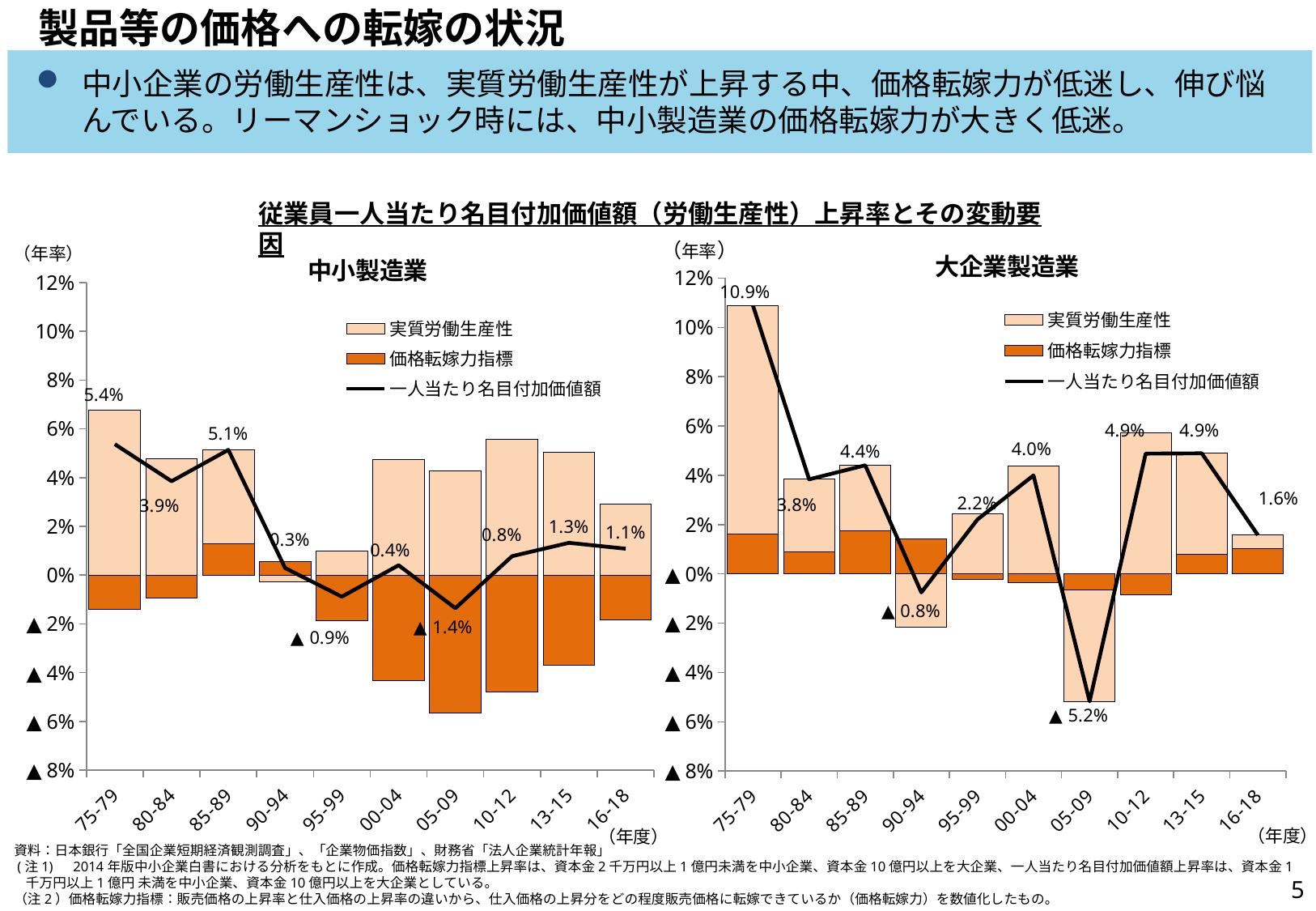
How many series does the legend of the 大企業製造業 chart list? 3 In the 大企業製造業 chart, what is the 一人当たり名目付加価値額 value for 05-09? ▲5.2% In the 中小製造業 chart, which is larger, the 一人当たり名目付加価値額 value for 13-15 or for 16-18? 13-15 In the 大企業製造業 chart, is the 実質労働生産性 bar for 75-79 greater or less than 8%? greater In the 大企業製造業 chart, does the 一人当たり名目付加価値額 line rise or fall from 13-15 to 16-18? fall What kind of chart is the 中小製造業 chart? Stacked bar chart with a line How many periods are shown on the x axis of the 中小製造業 chart? 10 In the 大企業製造業 chart, what is the difference between the 一人当たり名目付加価値額 values for 75-79 and 80-84? 7.1 percentage points In the 中小製造業 chart, is the 実質労働生産性 bar for 75-79 greater or less than 6%? greater In the 大企業製造業 chart, which period has the highest 一人当たり名目付加価値額 value? 75-79 In the 中小製造業 chart, what is the 一人当たり名目付加価値額 value for 75-79? 5.4% In the 中小製造業 chart, which period has the lowest 一人当たり名目付加価値額 value? 05-09